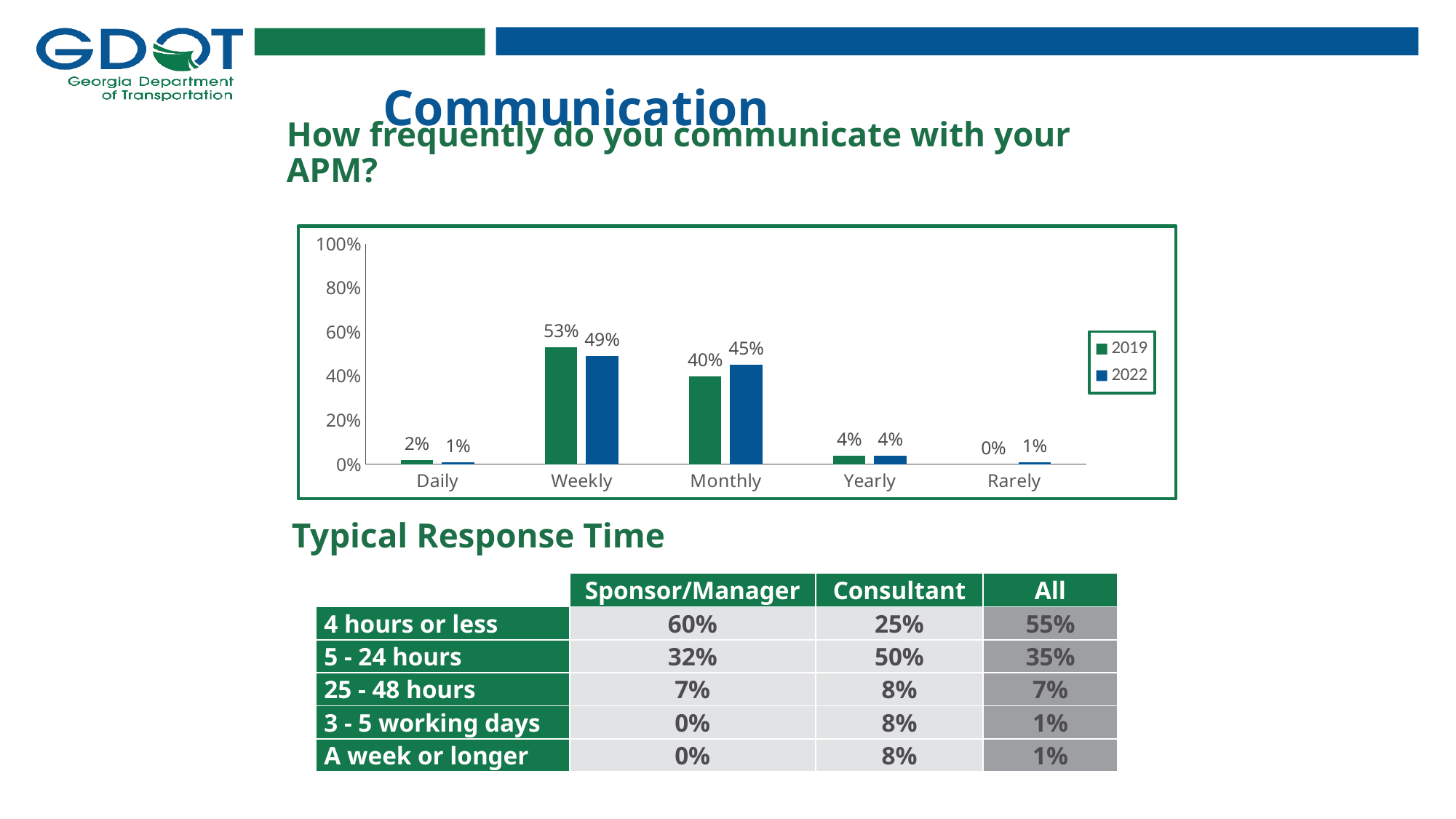
Which is larger for Monthly, the 2019 value or the 2022 value? 2022 Which category has the lowest 2019 value? Rarely How many categories are shown on the x axis? 5 What is the 2022 value for Monthly? 45% Which category has the highest 2019 value? Weekly What kind of chart is shown? bar chart What is the difference between the 2019 and 2022 values for Weekly? 4% What is the 2022 value for Daily? 1% How many series does the legend list? 2 What is the 2019 value for Weekly? 53% Which series is shown in blue? 2022 What is the 2019 value for Rarely? 0%